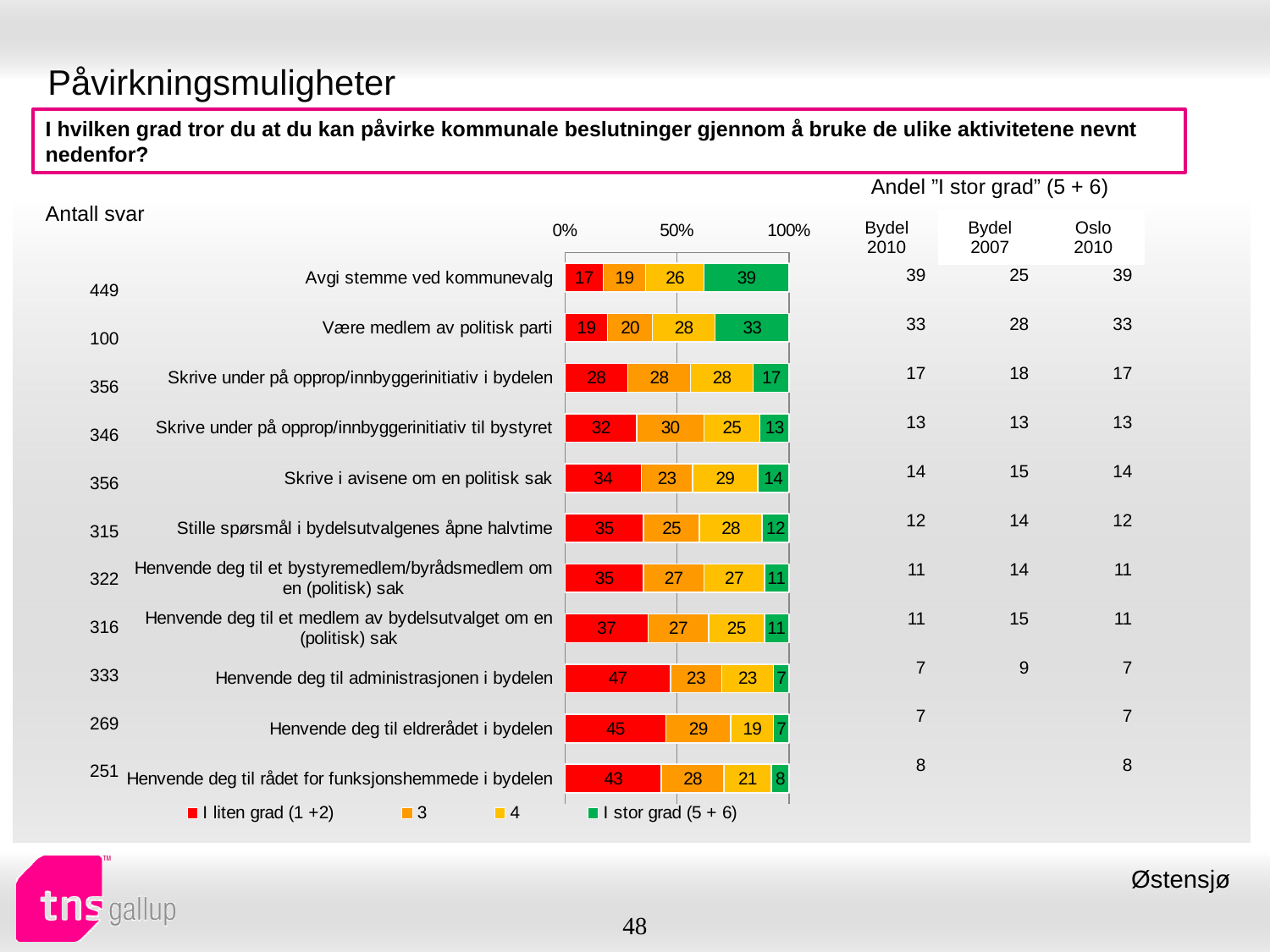
What kind of chart is shown on the slide? Stacked bar chart Which category has the lowest value for "I liten grad (1 +2)"? Avgi stemme ved kommunevalg What is the difference between the "I stor grad (5 + 6)" values for "Avgi stemme ved kommunevalg" and "Være medlem av politisk parti"? 6 What is the value of "I stor grad (5 + 6)" for "Avgi stemme ved kommunevalg"? 39 Which category has the highest value for "I liten grad (1 +2)"? Henvende deg til administrasjonen i bydelen How many categories are shown in the chart? 11 Which is larger: the "I liten grad (1 +2)" value for "Skrive i avisene om en politisk sak" or for "Skrive under på opprop/innbyggerinitiativ i bydelen"? Skrive i avisene om en politisk sak Which category has the highest value for "I stor grad (5 + 6)"? Avgi stemme ved kommunevalg What is the value of series "4" for "Henvende deg til eldrerådet i bydelen"? 19 What is the value of series "3" for "Skrive under på opprop/innbyggerinitiativ til bystyret"? 30 What is the value of "I liten grad (1 +2)" for "Henvende deg til administrasjonen i bydelen"? 47 How many series does the legend list? 4